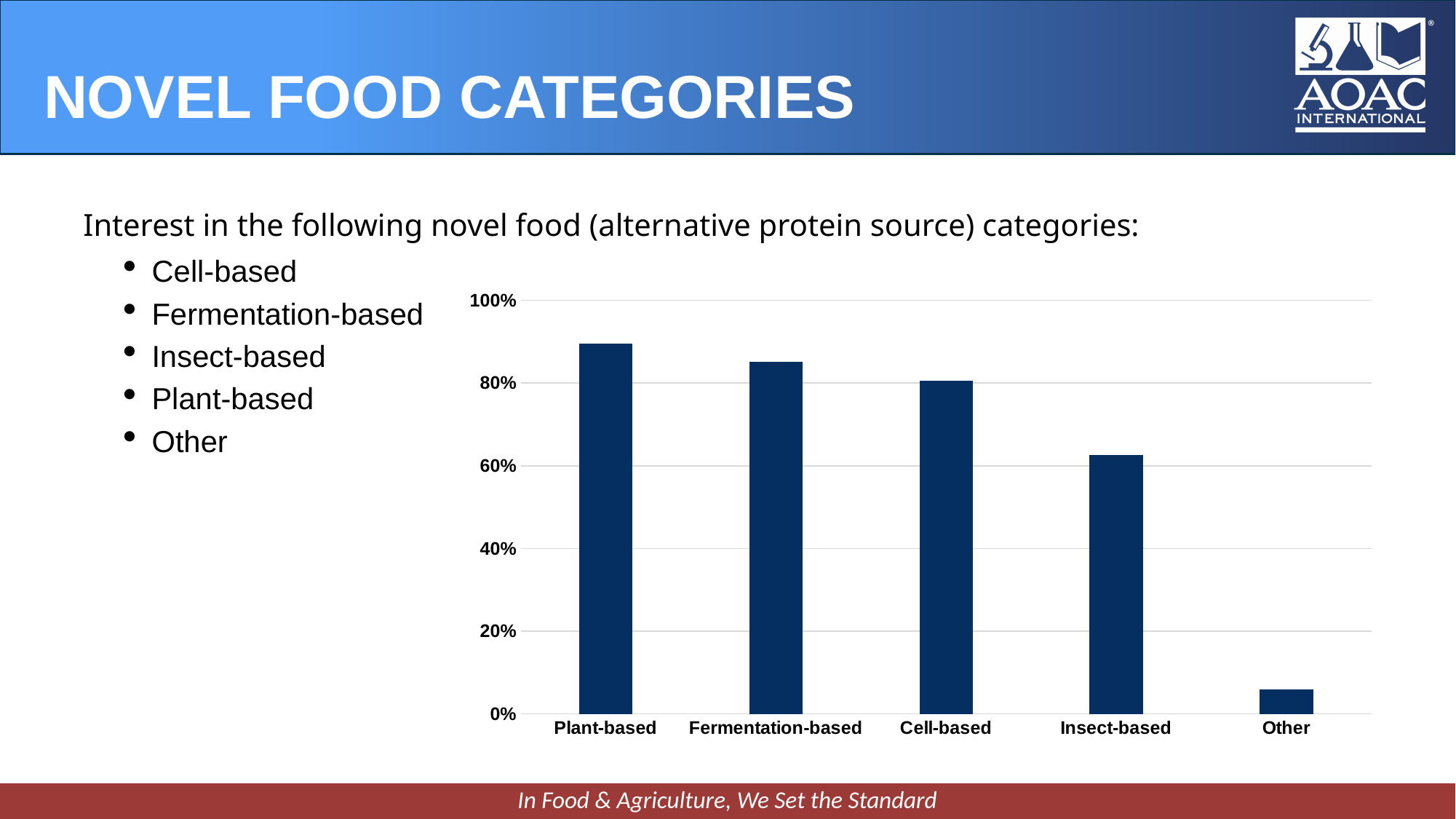
Which category has the lowest value on the chart? Other Which is larger, the value for Cell-based or the value for Insect-based? Cell-based Is the value for Plant-based greater or less than 80%? greater How many categories are plotted on the chart? 5 What kind of chart is shown on the slide? bar chart Is the value for Other greater or less than 20%? less Which category has the highest value on the chart? Plant-based Is the value for Fermentation-based greater or less than 80%? greater Which is larger, the value for Insect-based or the value for Other? Insect-based What is the label of the category shown on the far right of the x axis? Other Do the bar values rise or fall from left to right across the chart? fall